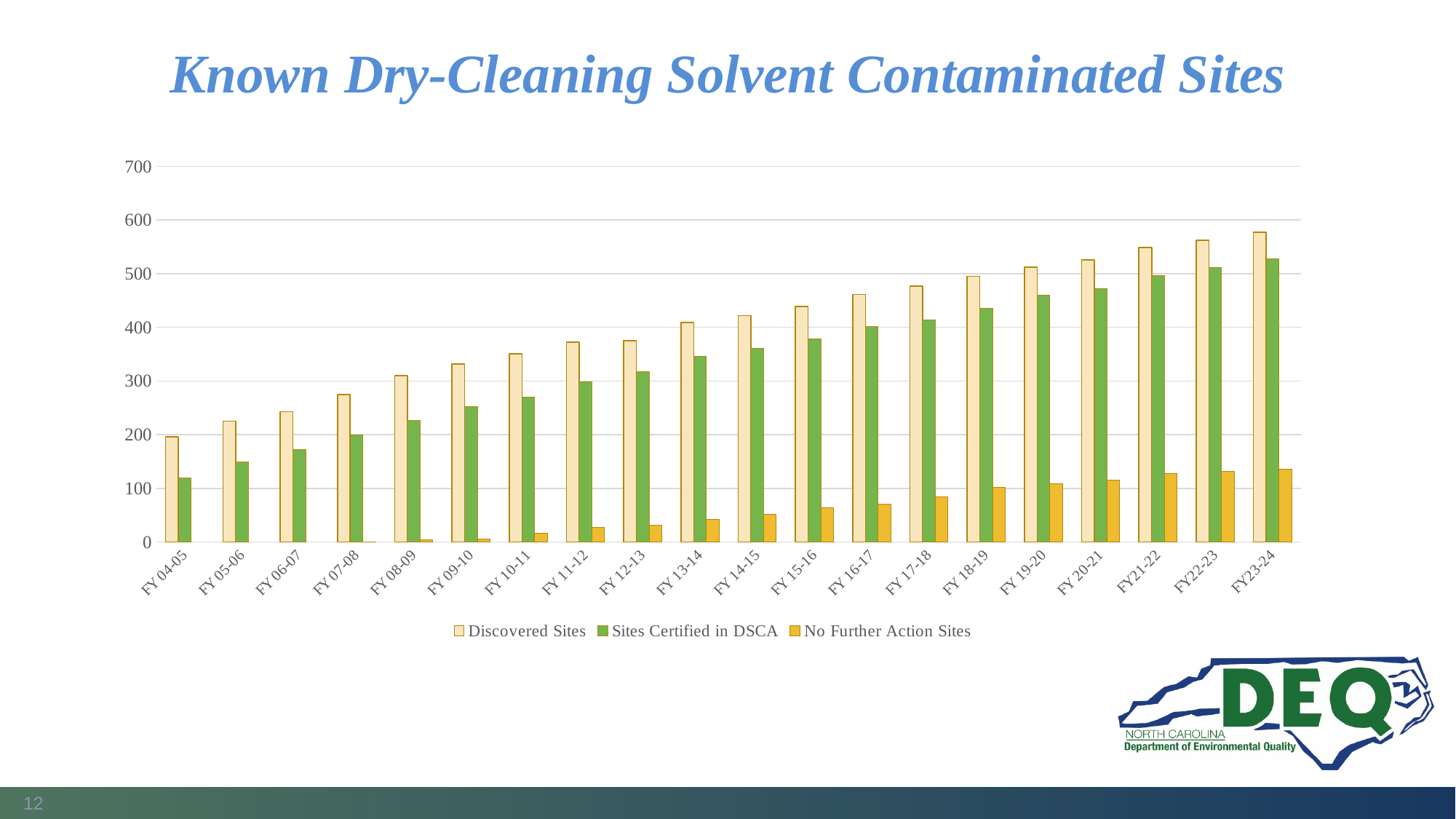
Is the value for Sites Certified in DSCA in FY23-24 greater or less than 500? greater What kind of chart is shown on the slide? bar chart Is the value for Discovered Sites in FY23-24 greater or less than 600? less Which fiscal year has the lowest value for Discovered Sites? FY 04-05 Which fiscal year has the highest value for Discovered Sites? FY23-24 Is the value for No Further Action Sites in FY23-24 greater or less than 100? greater How many fiscal years are shown on the x axis? 20 How many series does the legend list? 3 Do the values for Sites Certified in DSCA rise or fall from FY 04-05 to FY23-24? rise In FY 10-11, which is larger: Discovered Sites or Sites Certified in DSCA? Discovered Sites Which fiscal year has the highest value for No Further Action Sites? FY23-24